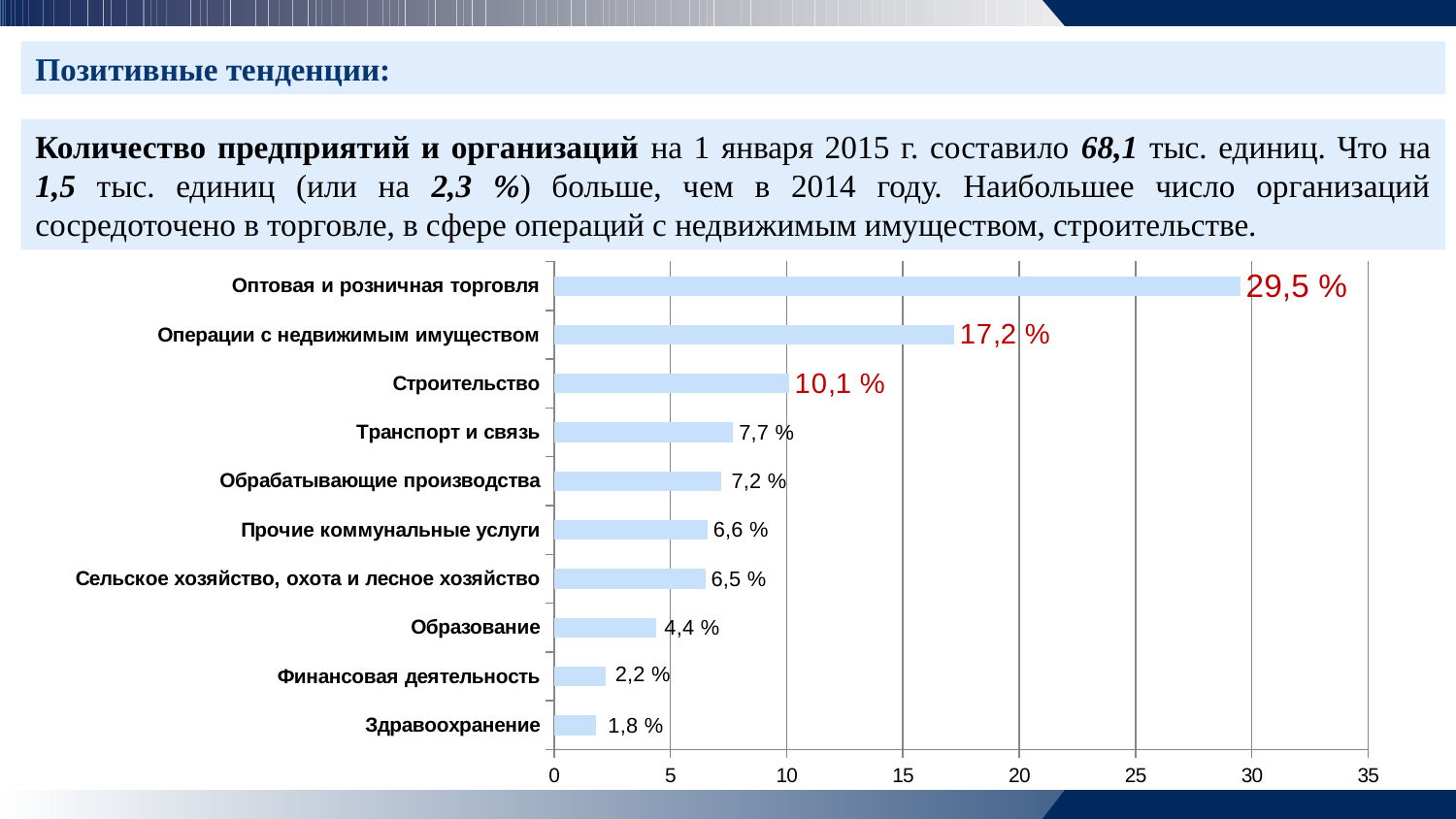
Is the value for Операции с недвижимым имуществом greater or less than 15? greater Which is larger, the value for Транспорт и связь or the value for Обрабатывающие производства? Транспорт и связь What kind of chart is shown on the slide? bar chart How many categories are shown in the chart? 10 What is the difference between the values for Оптовая и розничная торговля and Операции с недвижимым имуществом? 12,3 % What is the value for Здравоохранение? 1,8 % What is the value for Оптовая и розничная торговля? 29,5 % What is the maximum value shown on the horizontal axis? 35 What is the difference between the values for Образование and Финансовая деятельность? 2,2 % Which category has the highest value? Оптовая и розничная торговля What is the value for Строительство? 10,1 % Which category has the lowest value? Здравоохранение